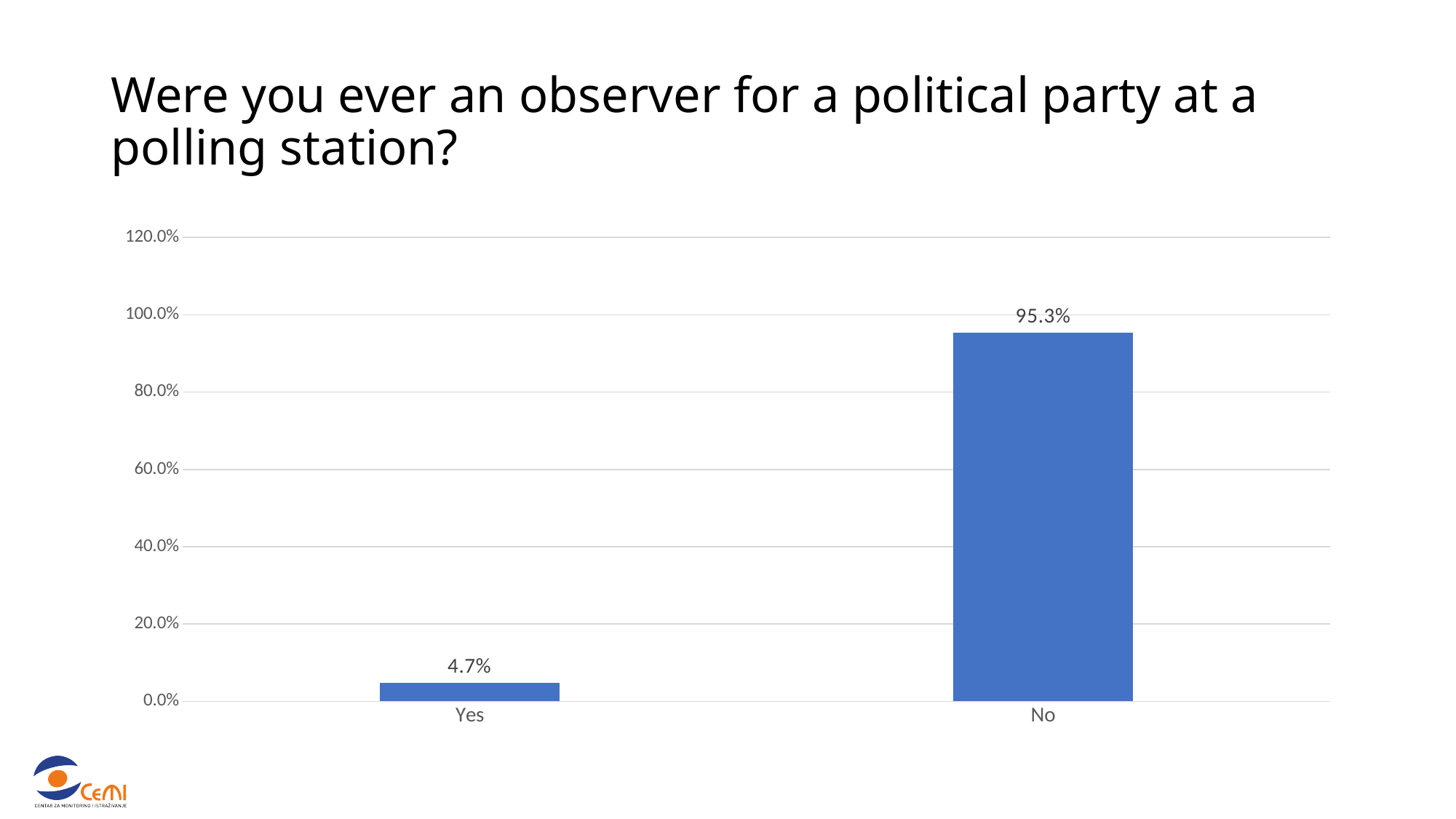
What is the difference between the "No" and "Yes" values? 90.6% What is the total of the "Yes" and "No" values? 100.0% Is the value for "Yes" greater or less than 20.0%? less What percentage of respondents answered "No"? 95.3% Which category has the highest value? No Is the value for "No" greater or less than 80.0%? greater Which is larger, the value for "Yes" or the value for "No"? No What percentage of respondents answered "Yes"? 4.7% What is the title of the chart on the slide? Were you ever an observer for a political party at a polling station? How many categories are shown on the x axis? 2 What kind of chart is shown on the slide? Bar chart Which category has the lowest value? Yes